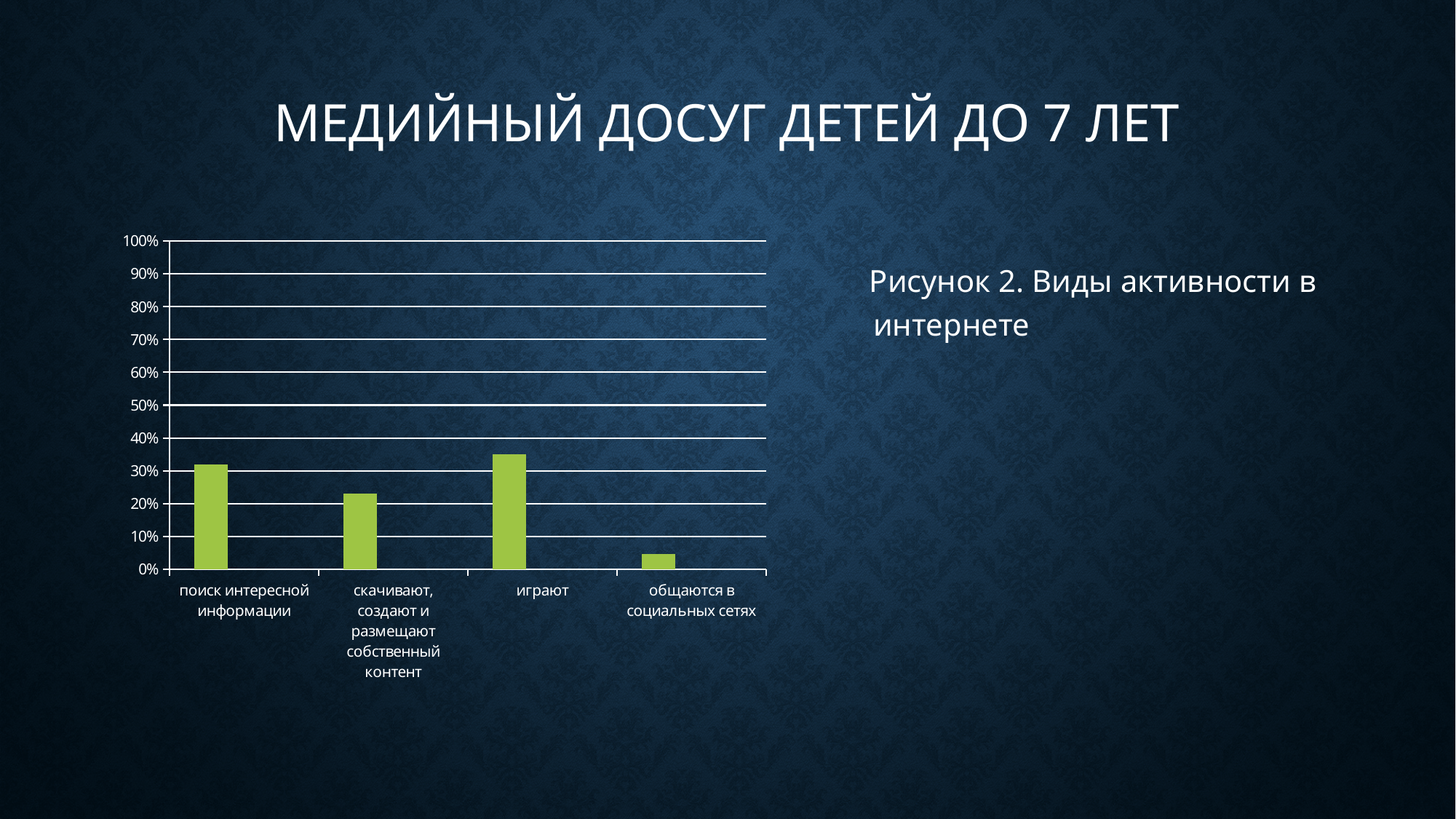
Is the value for "скачивают, создают и размещают собственный контент" greater or less than 30%? less What is the caption given for the chart on the slide? Рисунок 2. Виды активности в интернете What kind of chart is shown on the slide? bar chart Which is larger: the value for "играют" or the value for "скачивают, создают и размещают собственный контент"? играют Is the value for "общаются в социальных сетях" greater or less than 10%? less Which category has the lowest bar in the chart? общаются в социальных сетях Which category has the highest bar in the chart? играют Which is larger: the value for "поиск интересной информации" or the value for "общаются в социальных сетях"? поиск интересной информации Is the value for "поиск интересной информации" greater or less than 40%? less How many categories are shown on the x axis of the chart? 4